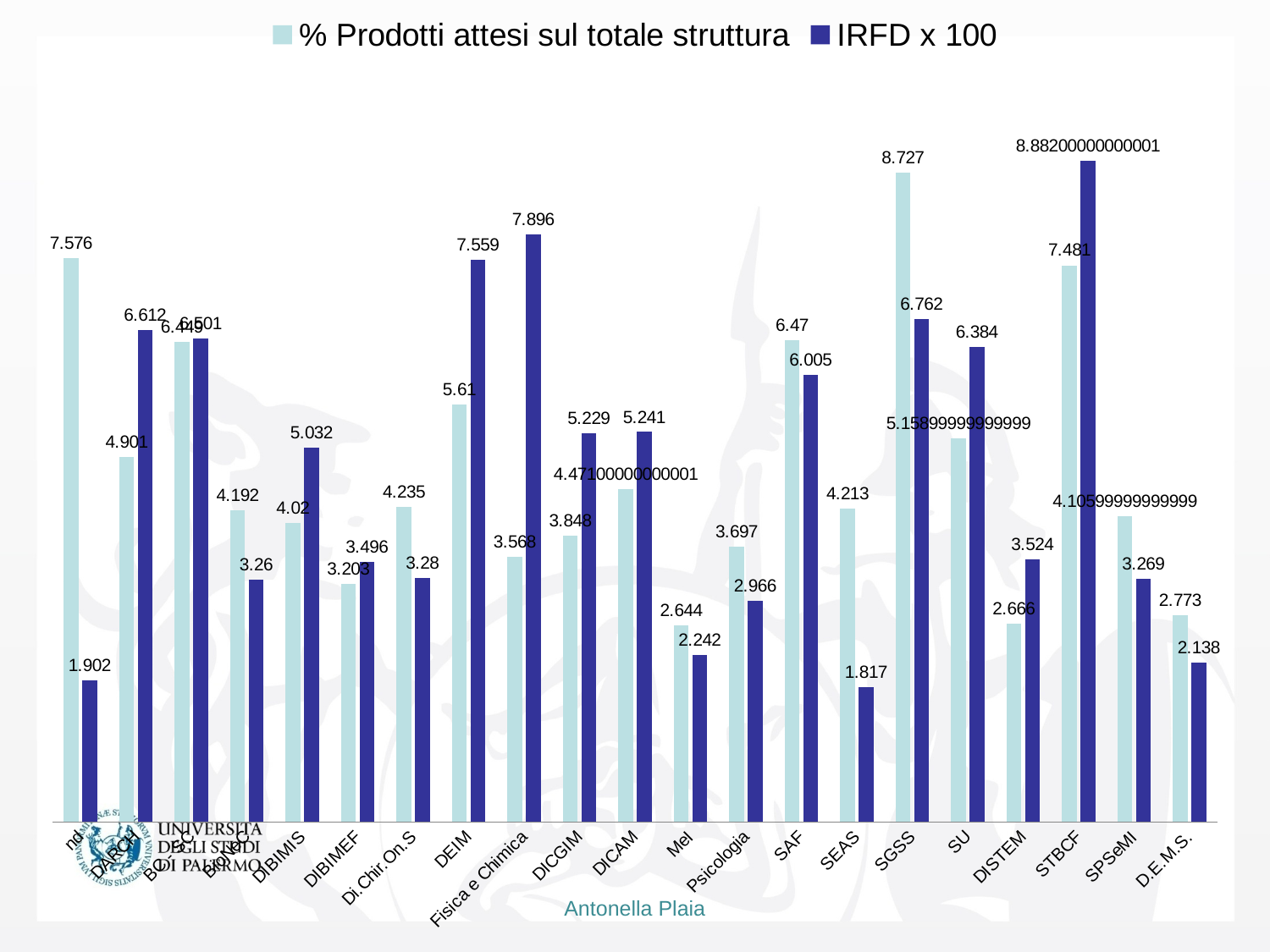
What is the difference between the "% Prodotti attesi sul totale struttura" and "IRFD x 100" values for nd? 5.674 What is the value of "% Prodotti attesi sul totale struttura" for DEIM? 5.61 What kind of chart is shown on the slide? bar chart Which category has the highest "IRFD x 100" value? STBCF What is the value of "IRFD x 100" for nd? 1.902 How many categories are shown on the x axis? 21 What is the value of "IRFD x 100" for Fisica e Chimica? 7.896 How many series does the legend list? 2 Which category has the lowest "IRFD x 100" value? SEAS For SAF, which is larger: "% Prodotti attesi sul totale struttura" or "IRFD x 100"? % Prodotti attesi sul totale struttura Which category has the highest "% Prodotti attesi sul totale struttura" value? SGSS What is the value of "% Prodotti attesi sul totale struttura" for SGSS? 8.727